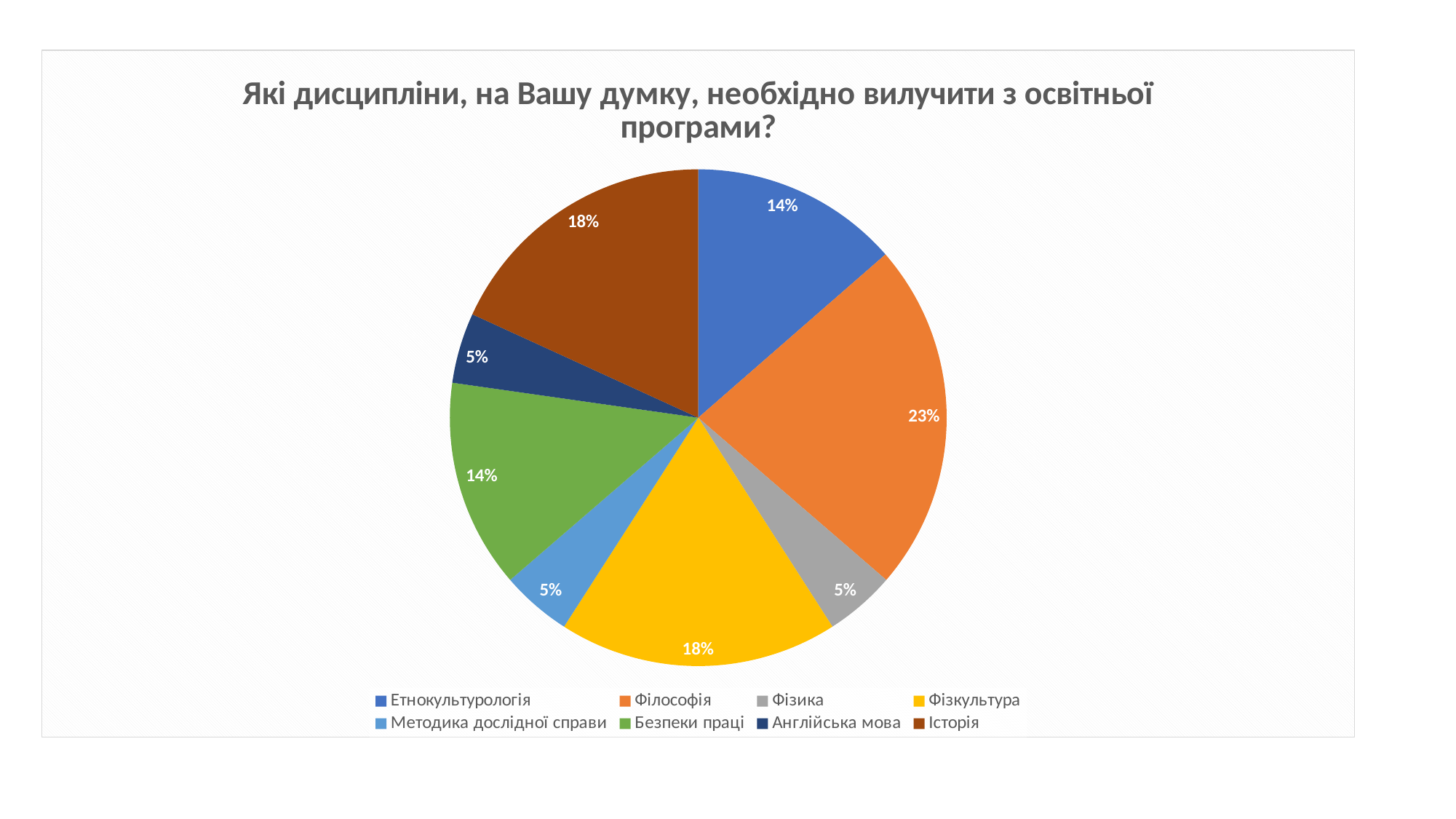
Which is larger, the share for Історія or the share for Англійська мова? Історія What is the combined share of Фізкультура and Історія? 36% What is the value shown for Фізика? 5% How many categories does the legend list? 8 What is the difference between the shares of Філософія and Фізкультура? 5% What is the value shown for Історія? 18% What kind of chart is shown on the slide? pie chart What colour is the slice for Фізкультура? yellow Which category has the largest slice of the pie? Філософія What is the value shown for Етнокультурологія? 14% What share of the pie does Філософія have? 23% What is the value shown for Безпеки праці? 14%